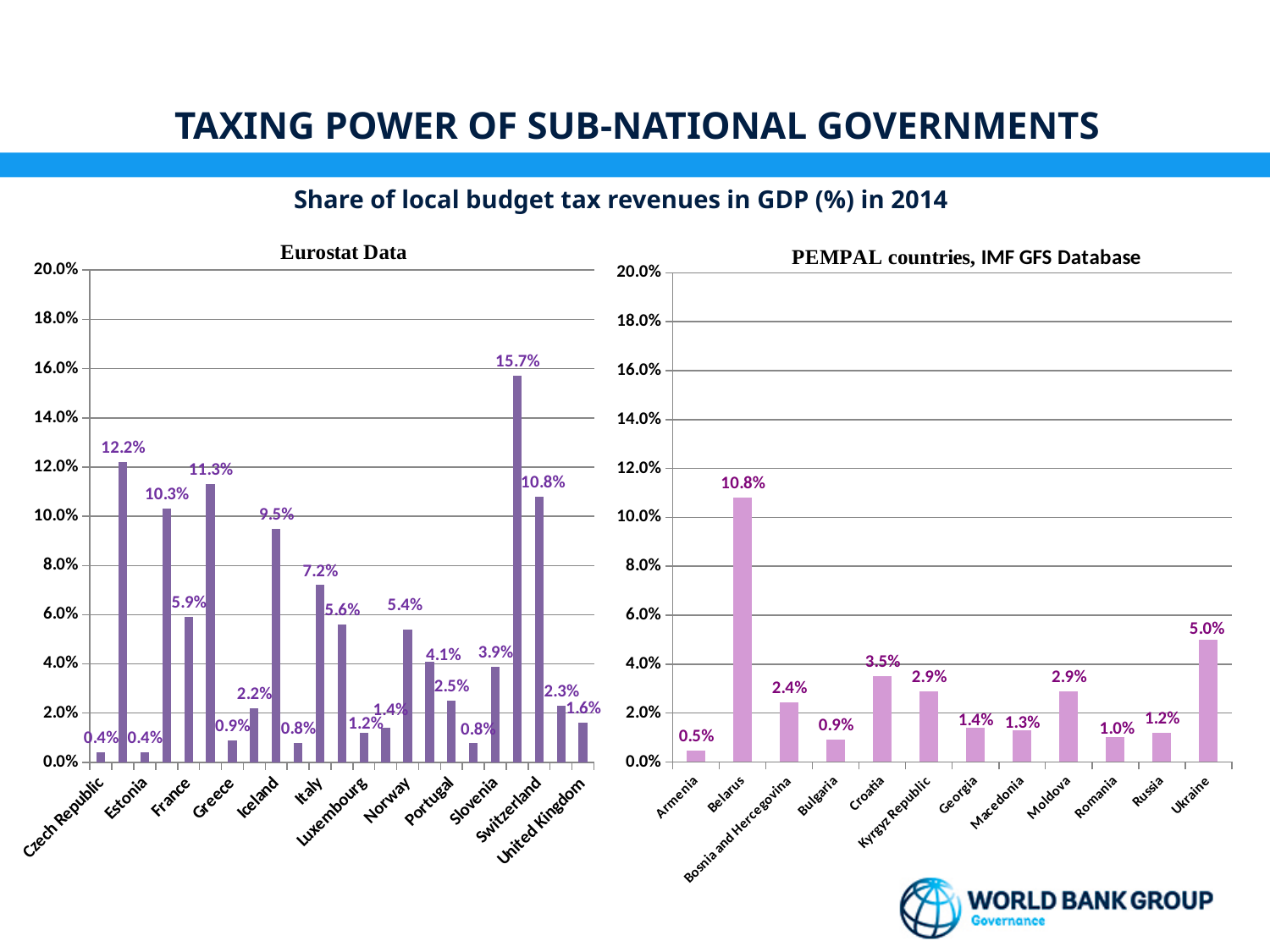
What is the title of the chart on the right side of the slide? PEMPAL countries, IMF GFS Database In the PEMPAL countries chart, which country has the lowest share? Armenia In the PEMPAL countries chart, what is the value for Ukraine? 5.0% In the Eurostat Data chart, what is the highest value shown? 15.7% In the PEMPAL countries chart, which country has the highest share? Belarus What kind of chart is the Eurostat Data chart? Bar chart In the PEMPAL countries chart, what is the value for Belarus? 10.8% In the PEMPAL countries chart, which is larger, the value for Croatia or the value for Bosnia and Hercegovina? Croatia In the PEMPAL countries chart, is the value for Belarus greater or less than 10.0%? greater In the PEMPAL countries chart, what is the difference between the values for Belarus and Ukraine? 5.8% How many countries are shown in the PEMPAL countries chart? 12 In the PEMPAL countries chart, what is the value for Croatia? 3.5%